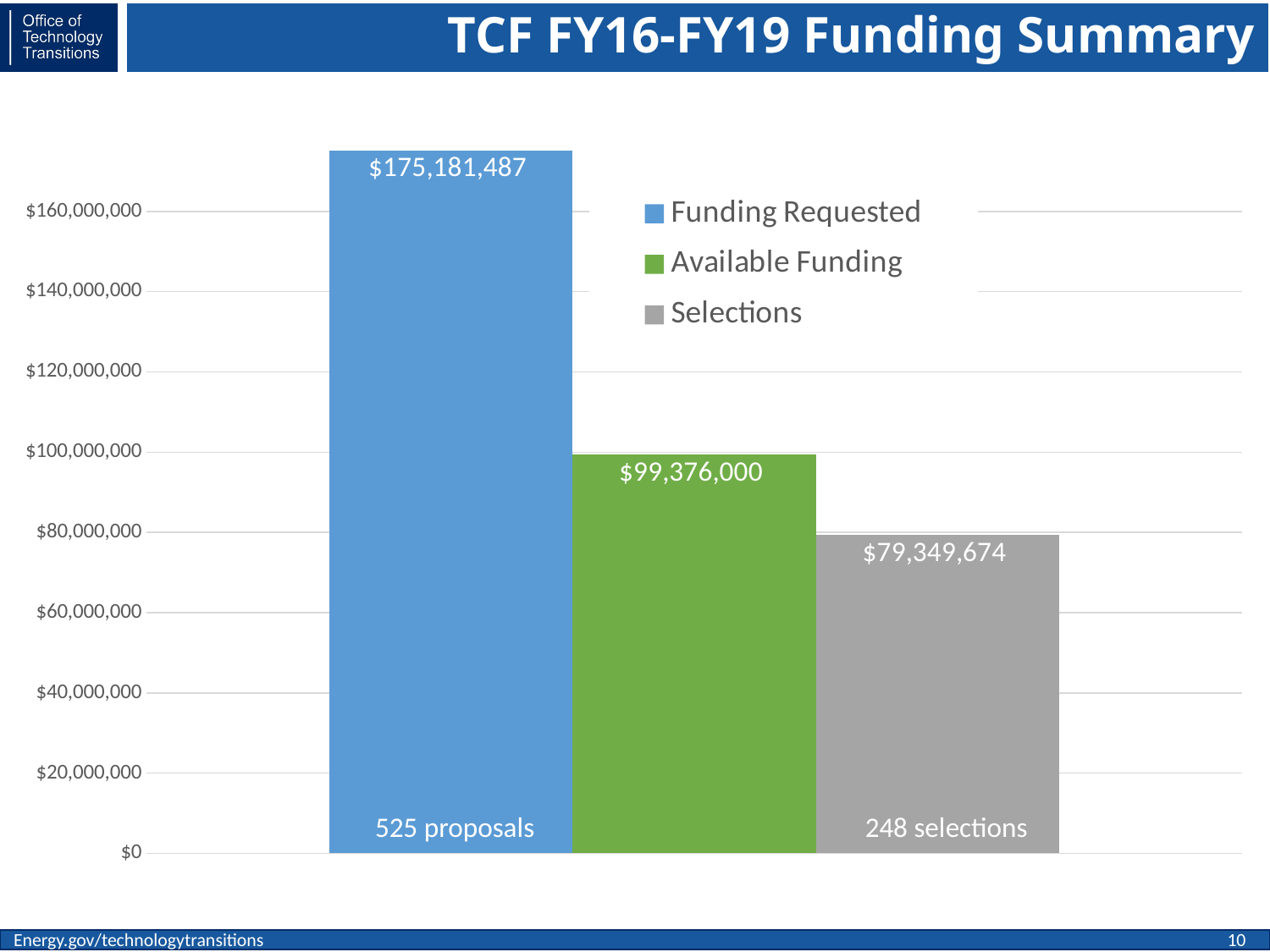
What kind of chart is shown on the slide? Bar chart Which is larger, Available Funding or Selections? Available Funding What is the difference between Available Funding and Selections? $20,026,326 What is the value of the Available Funding bar? $99,376,000 What is the value of the Selections bar? $79,349,674 Which series has the highest value? Funding Requested How many proposals are noted on the Funding Requested bar? 525 proposals How many series does the legend list? 3 What is the difference between Funding Requested and Available Funding? $75,805,487 Which series has the lowest value? Selections Is the value for Selections greater or less than $80,000,000? less What is the value of the Funding Requested bar? $175,181,487